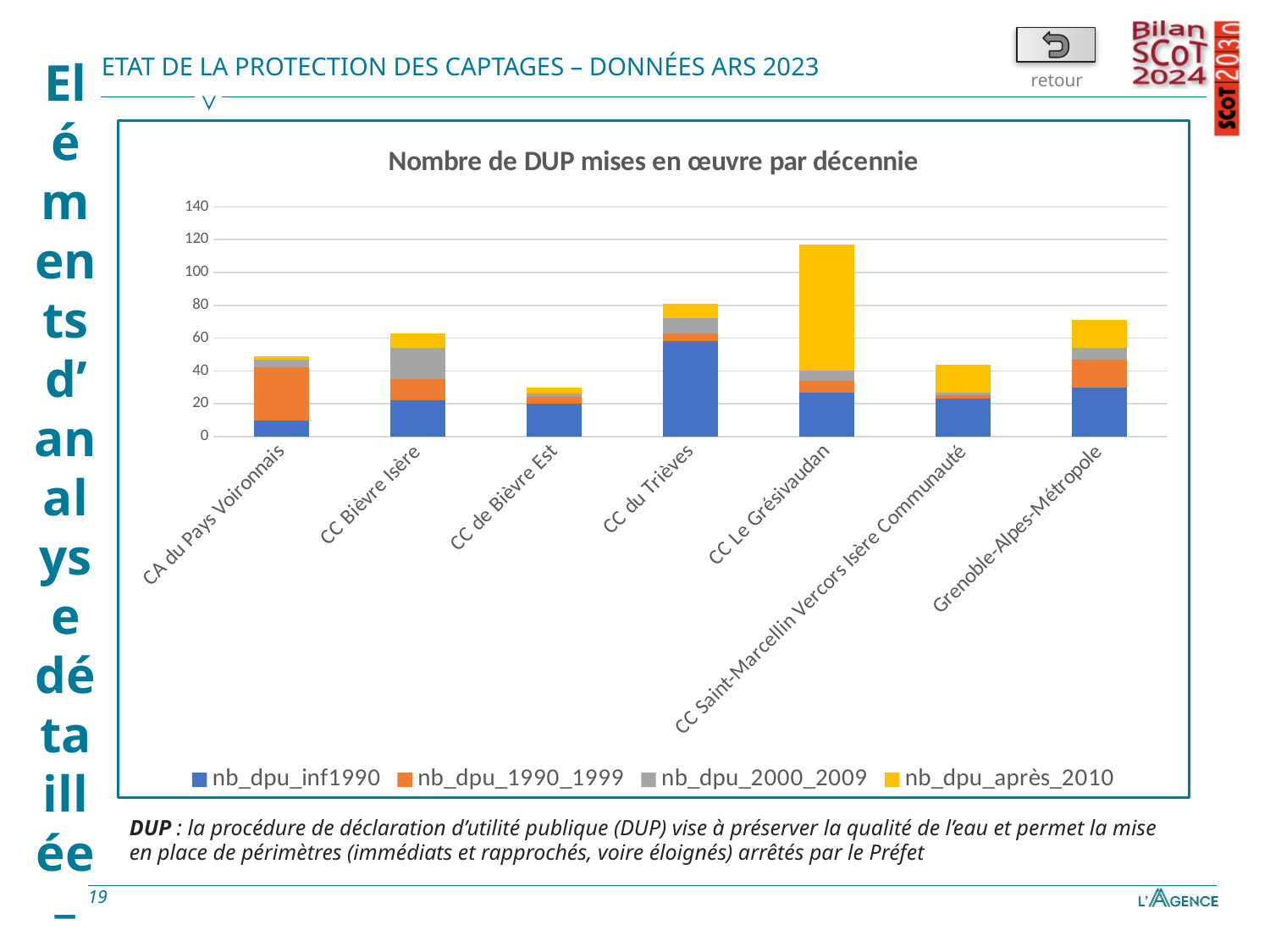
How many territories (categories) are shown on the x axis? 7 Which territory has the lowest total number of DUP? CC de Bièvre Est Which series is shown in yellow in the legend? nb_dpu_après_2010 How many series does the legend list? 4 Is the total bar for CC Le Grésivaudan greater or less than 100? greater Which territory has the highest total number of DUP? CC Le Grésivaudan Is the total bar for Grenoble-Alpes-Métropole greater or less than 60? greater What is the title of the chart? Nombre de DUP mises en œuvre par décennie What kind of chart is shown on the slide? Stacked bar chart Which territory has the largest nb_dpu_inf1990 (blue) segment? CC du Trièves Is the total bar for CC de Bièvre Est greater or less than 40? less Which has a larger total bar, CC du Trièves or CC Bièvre Isère? CC du Trièves